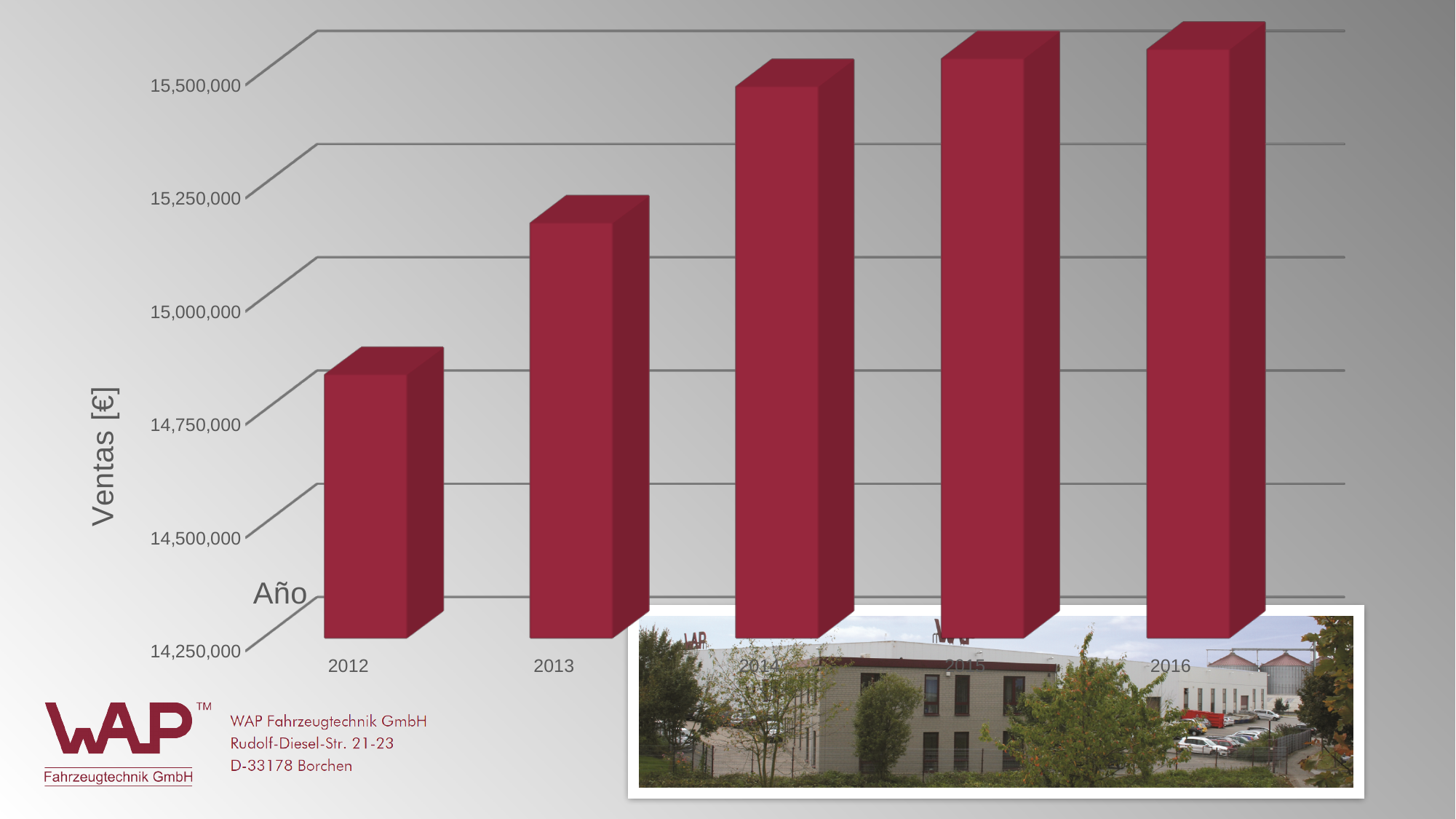
Is the value for 2012 greater or less than 15,000,000? less What is the label of the vertical axis of the chart? Ventas [€] What is the label of the horizontal axis of the chart? Año Is the value for 2012 greater or less than 14,500,000? greater Is the value for 2013 greater or less than 15,000,000? greater Do the sales values rise or fall from 2012 to 2016? rise Which year has the lowest sales value in the chart? 2012 What kind of chart is shown on the slide? bar chart How many years are shown on the x axis of the chart? 5 Which year has the larger value, 2013 or 2014? 2014